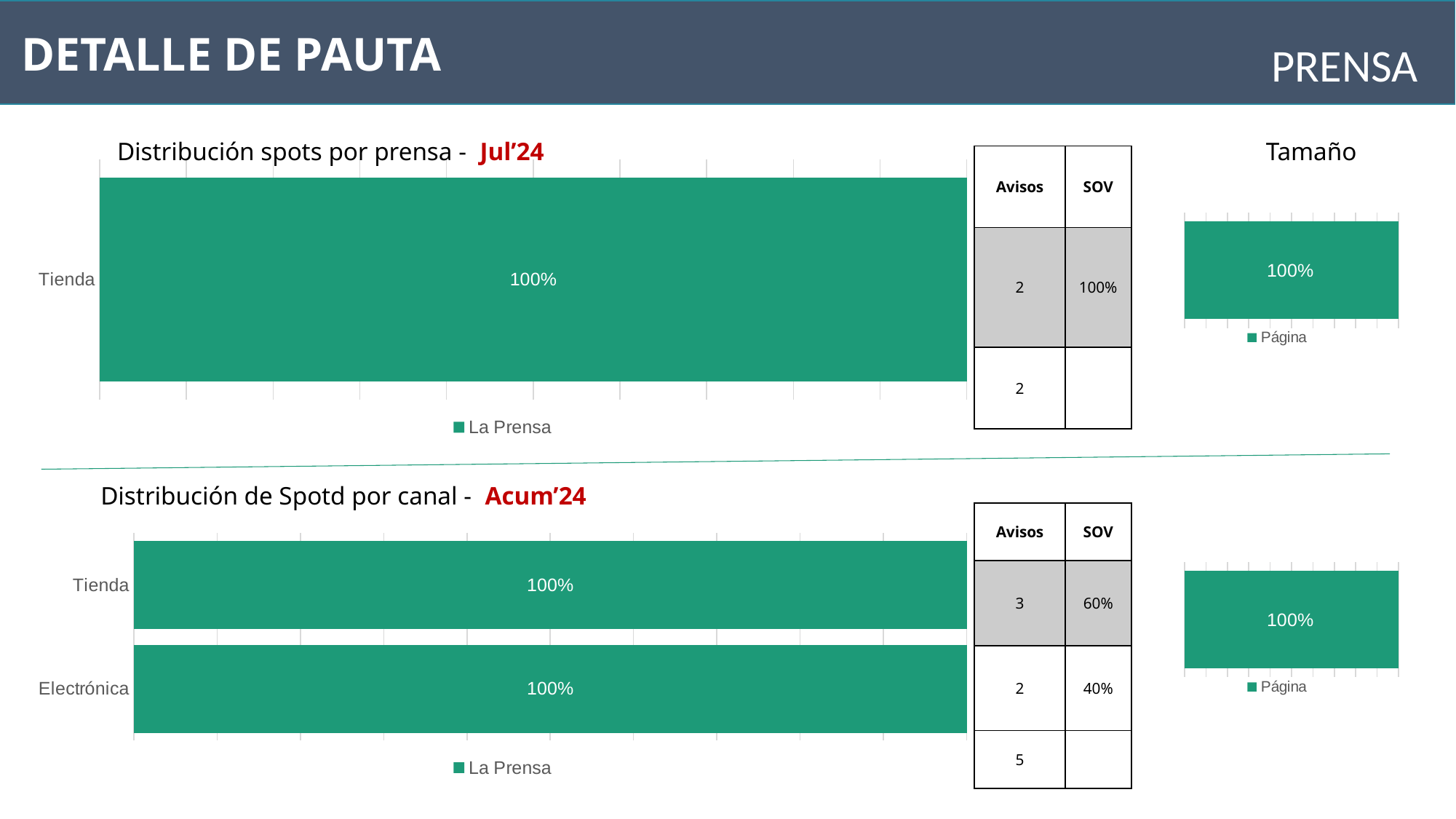
What kind of chart is "Distribución spots por prensa - Jul'24"? bar chart In the chart titled "Distribución de Spotd por canal - Acum'24", what is the value shown for Tienda? 100% How many series does the legend list in the chart "Distribución spots por prensa - Jul'24"? 1 How many categories are plotted in the chart "Distribución de Spotd por canal - Acum'24"? 2 In the chart "Distribución de Spotd por canal - Acum'24", what is the difference between the values for Tienda and Electrónica? 0% In the "Tamaño" chart at the top right of the slide, what value is printed on the bar? 100% How many categories are plotted in the chart "Distribución spots por prensa - Jul'24"? 1 In the chart titled "Distribución spots por prensa - Jul'24", what is the value shown for Tienda? 100% What series name appears in the legend of the chart "Distribución spots por prensa - Jul'24"? La Prensa How many series does the legend list in the small chart at the bottom right of the slide? 1 In the chart titled "Distribución de Spotd por canal - Acum'24", what is the value shown for Electrónica? 100% What series name appears in the legend of the "Tamaño" chart at the top right of the slide? Página